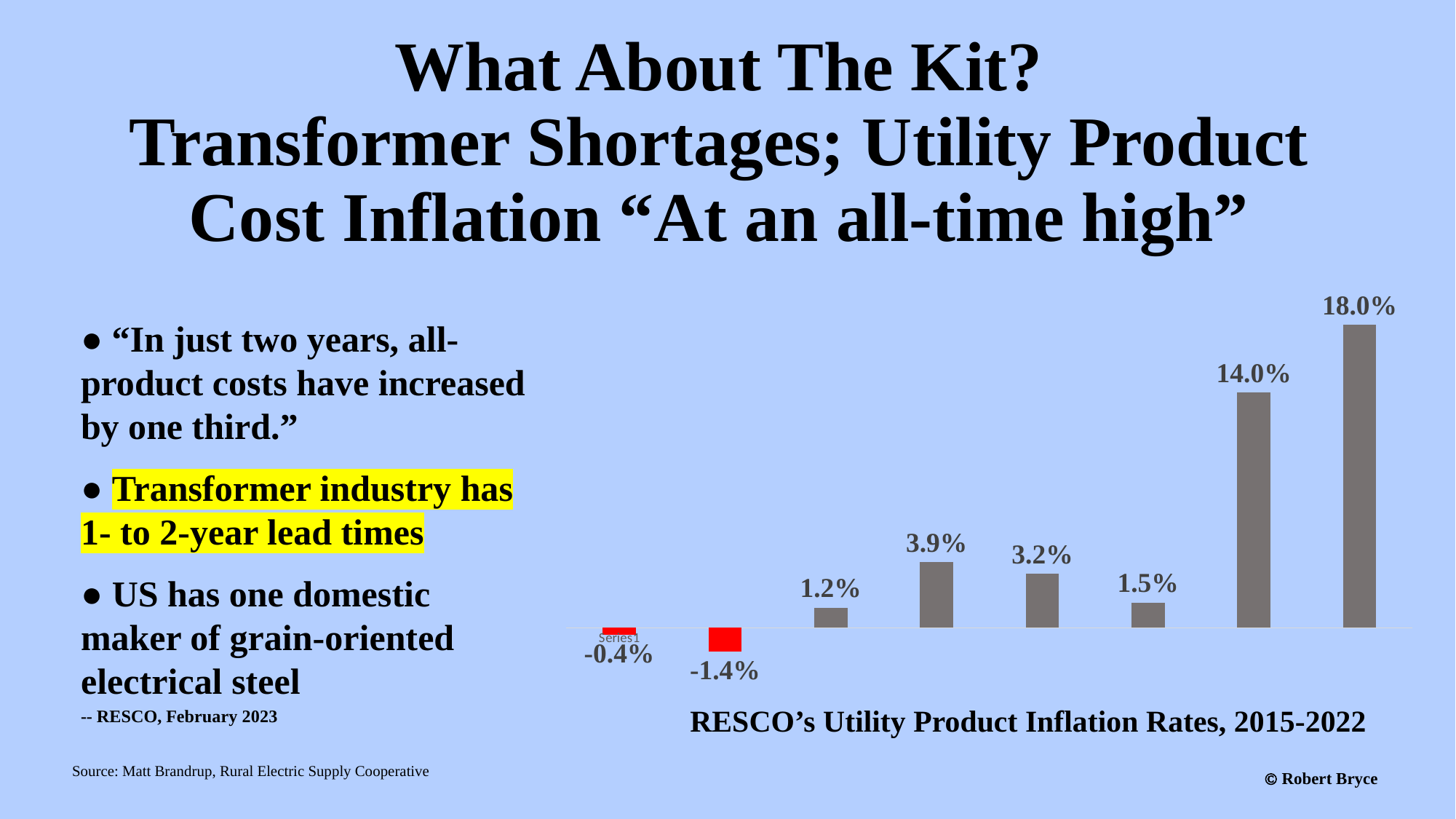
What is the highest value shown in the chart? 18.0% Do the values of the last three bars rise or fall from left to right? rise How many bars in the chart have negative values? 2 What kind of chart is shown on the slide? bar chart What is the difference between the two tallest bars (18.0% and 14.0%)? 4.0% What is the title of the chart? RESCO's Utility Product Inflation Rates, 2015-2022 How many bars are plotted in the chart? 8 What is the value of the third bar from the left? 1.2% What is the value of the second-tallest bar in the chart? 14.0% Which is larger, the fourth bar from the left (3.9%) or the fifth bar from the left (3.2%)? the fourth bar (3.9%) What is the lowest value shown in the chart? -1.4% What is the difference between the 3.9% bar and the 3.2% bar? 0.7%